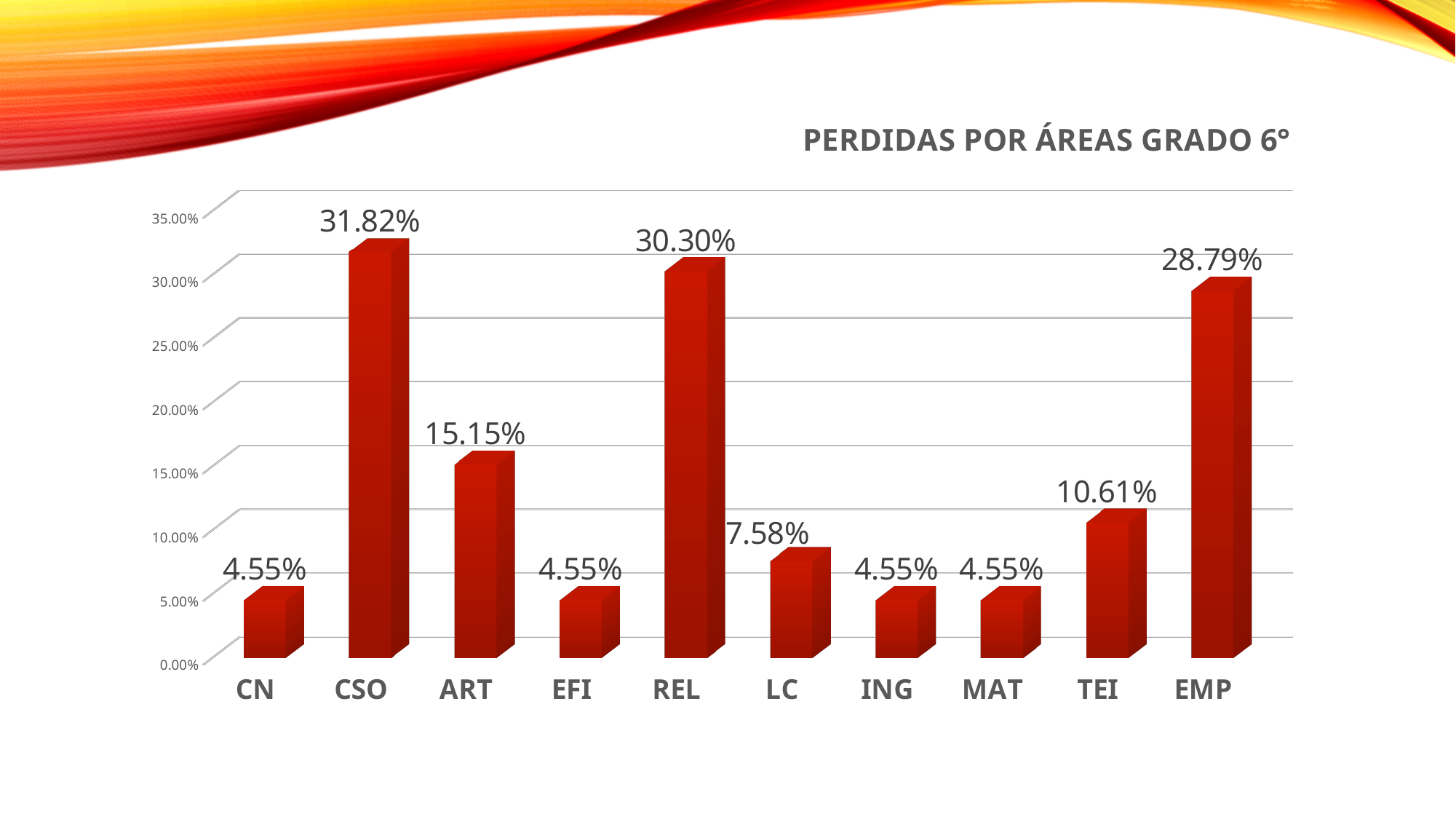
What is the difference between the values for CSO and REL? 1.52% Which is larger, the value for REL or the value for EMP? REL What is the value for EMP? 28.79% Is the value for ART greater or less than 20.00%? less What kind of chart is shown on the slide? bar chart What is the value for TEI? 10.61% What is the value for CSO? 31.82% Which area has the highest value? CSO What is the title of the chart? PERDIDAS POR ÁREAS GRADO 6° What is the value for LC? 7.58% How many areas are shown on the x axis? 10 What is the difference between the values for ART and TEI? 4.54%